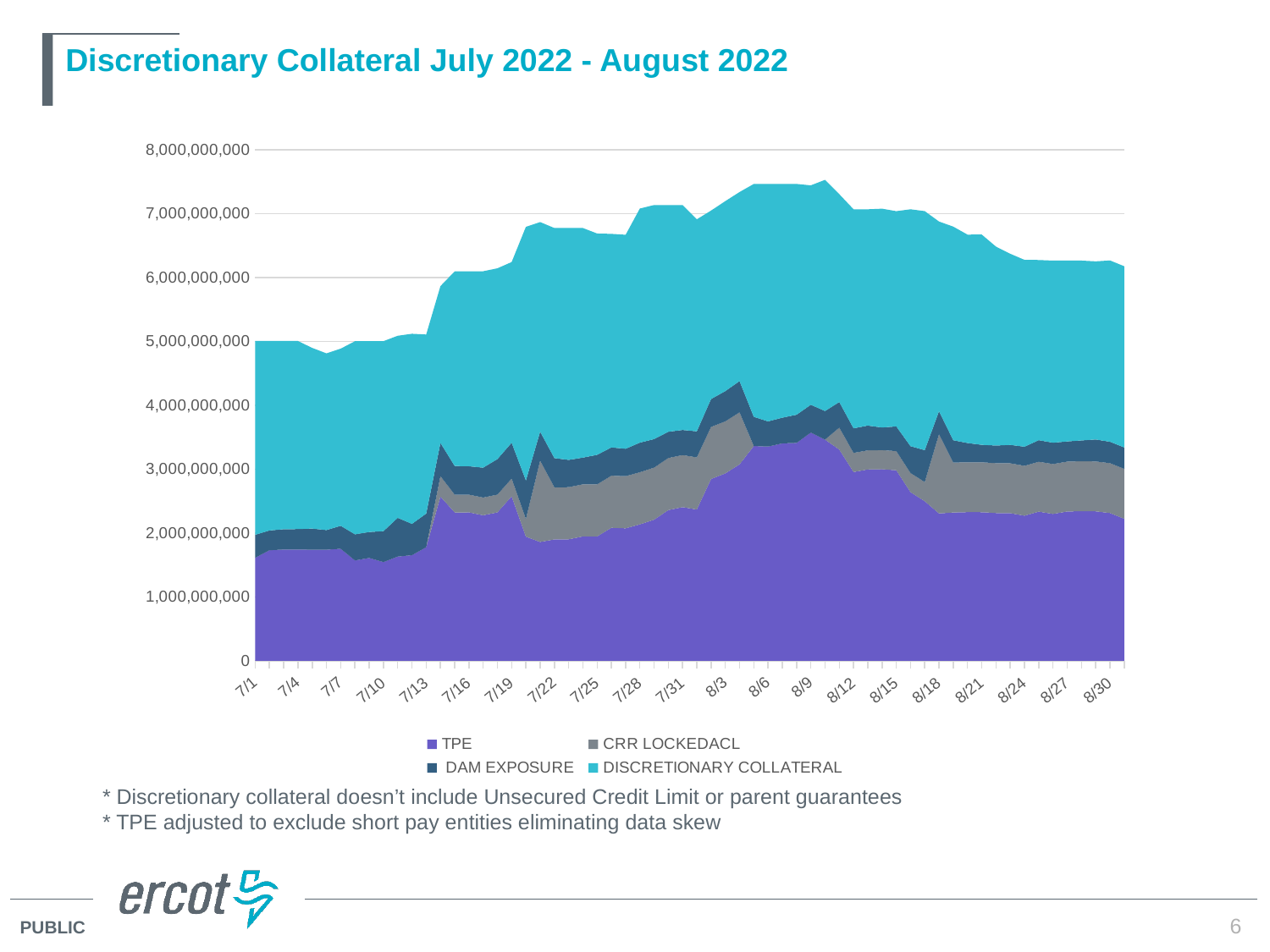
Which is larger, the total stacked value on 8/9 or on 7/1? 8/9 What is the title of the chart? Discretionary Collateral July 2022 - August 2022 Is the total stacked value on 8/30 greater or less than 6,000,000,000? greater Which series is plotted at the bottom of the stack? TPE How many series does the legend list? 4 Is the TPE value on 8/9 greater or less than 3,000,000,000? greater What kind of chart is shown on the slide? Stacked area chart Is the total stacked value on 8/9 greater or less than 7,000,000,000? greater How many date labels are shown on the x axis? 21 Does the total stacked value rise or fall from 8/9 to 8/30? fall Does the total stacked value rise or fall from 7/1 to 7/22? rise